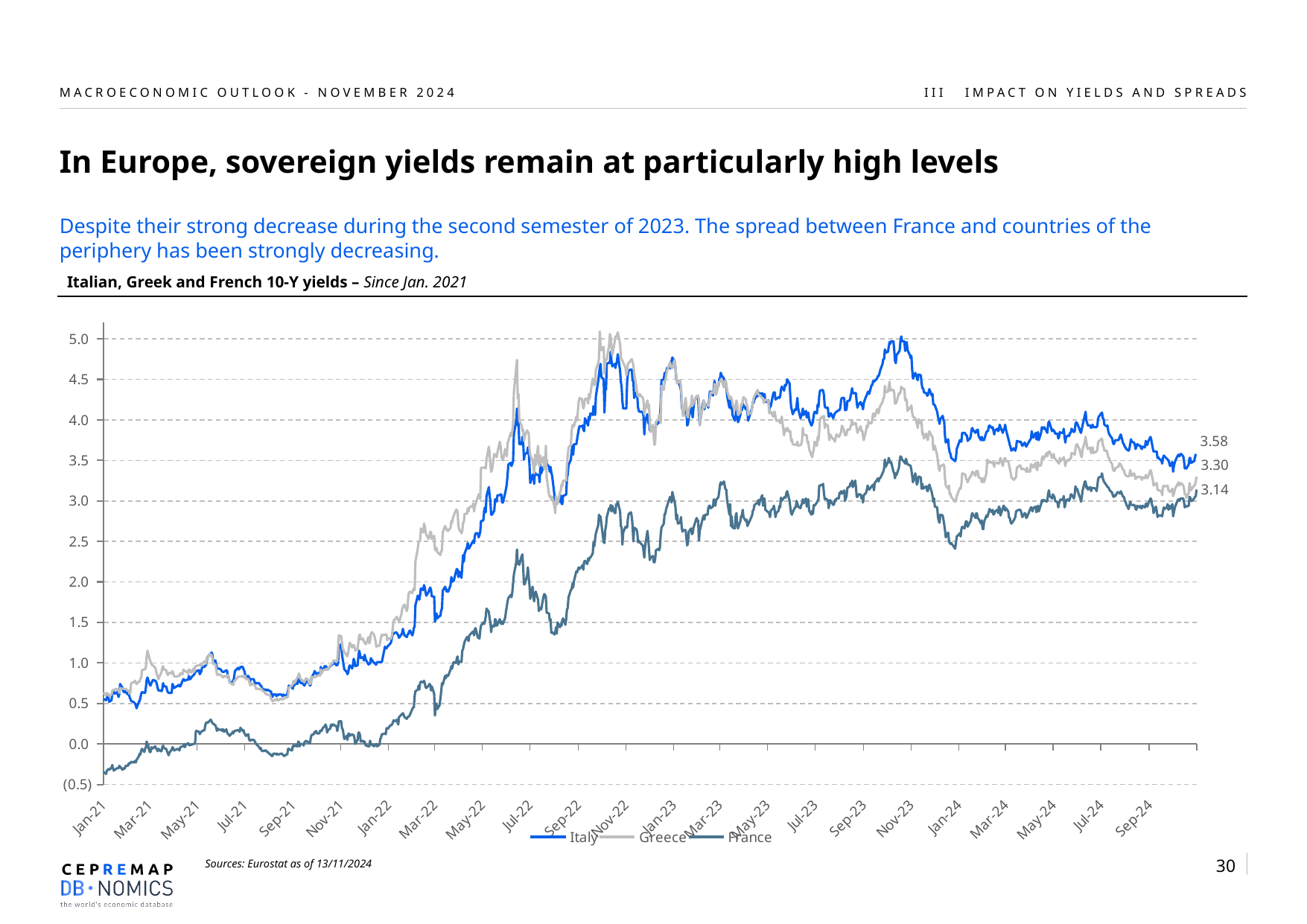
What kind of chart is shown on the slide? line chart How many series does the legend list? 3 What is the title of the chart? Italian, Greek and French 10-Y yields – Since Jan. 2021 What is the latest value labelled for Greece at the right end of the chart? 3.30 Does the France series rise or fall overall from Jan-21 to Sep-24? rise Is the value for France in Jan-21 greater or less than 0.0? less What is the difference between the latest labelled values for Italy and Greece? 0.28 What is the latest value labelled for Italy at the right end of the chart? 3.58 Which series has the lowest value at the right end of the chart? France What is the latest value labelled for France at the right end of the chart? 3.14 Which series has the highest value at the right end of the chart? Italy What is the difference between the latest labelled values for Italy and France? 0.44